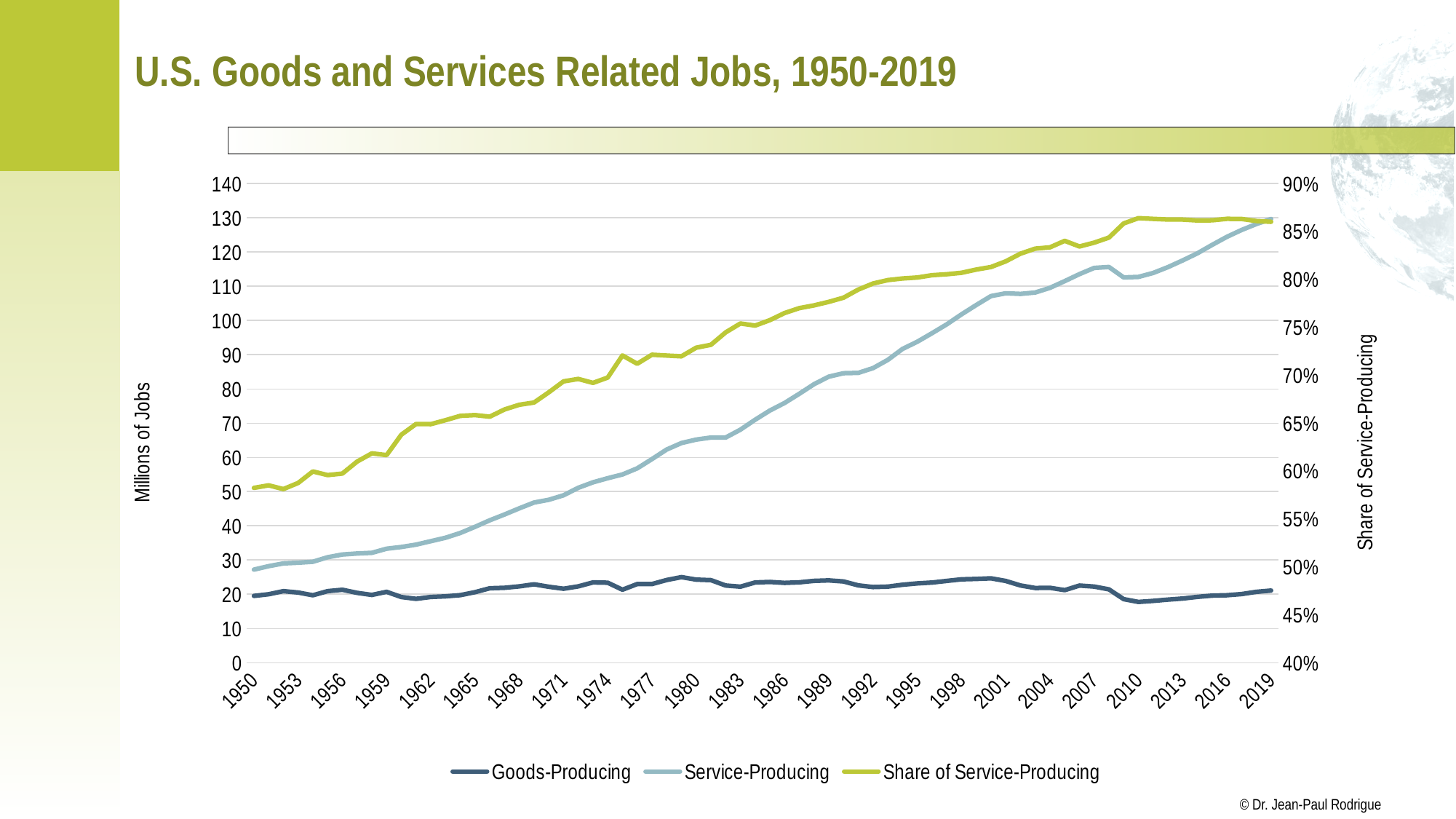
Does the Service-Producing line rise or fall from 1950 to 2019? Rises What is the label of the right-hand vertical axis? Share of Service-Producing Is the value for Goods-Producing in 2010 greater or less than 20? less How many series does the legend list? 3 In 2019, which is larger: Goods-Producing or Service-Producing jobs? Service-Producing What type of chart is shown on the slide? Line chart What is the title of the chart? U.S. Goods and Services Related Jobs, 1950-2019 Is the Share of Service-Producing in 1950 greater or less than 60%? less Is the value for Service-Producing in 1950 greater or less than 30? less Which series reaches the highest value on the Millions of Jobs axis? Service-Producing